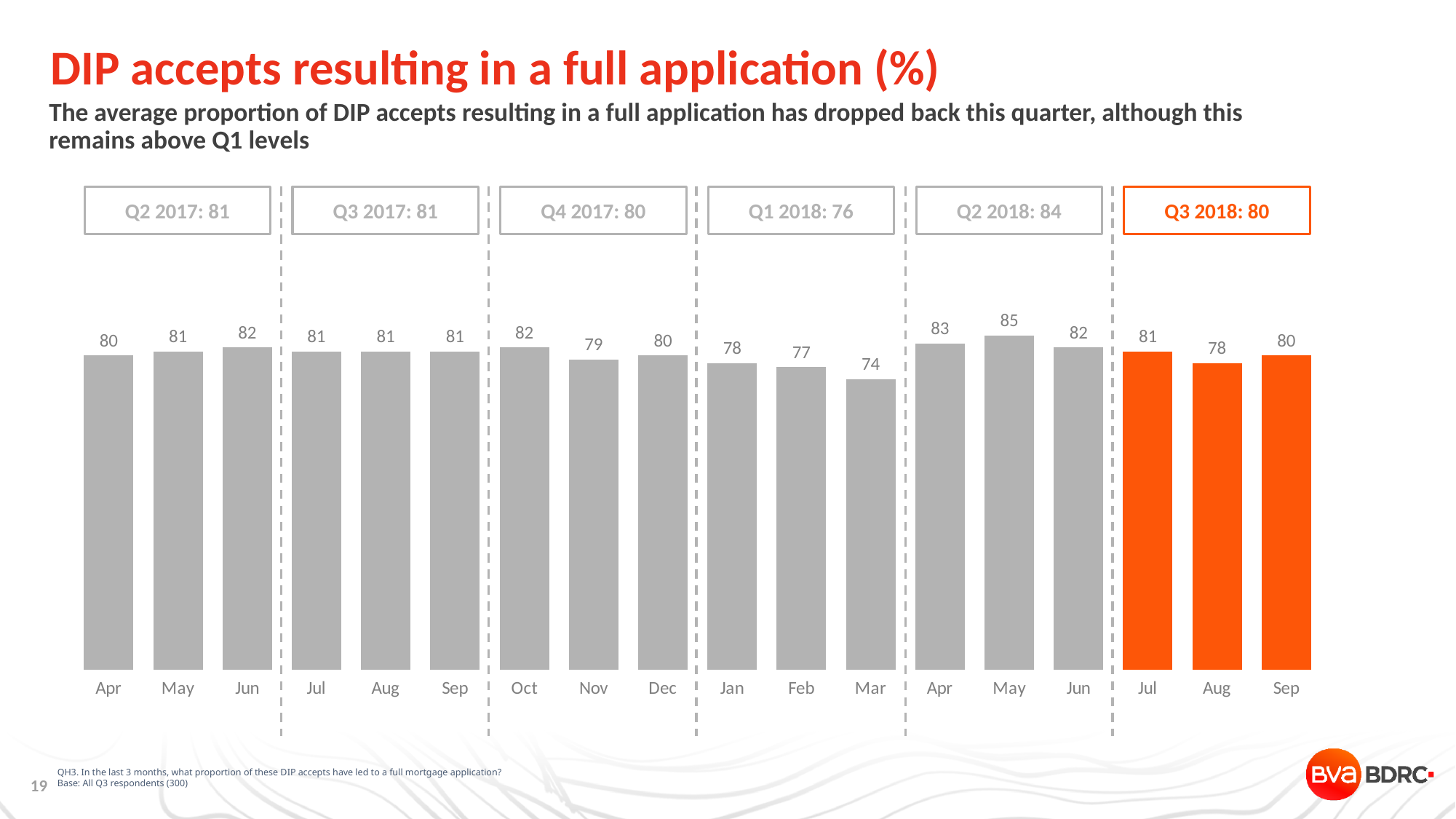
Do the values rise or fall across the three months of Q1 2018 (Jan to Mar)? Fall What is the value for Nov (Q4 2017)? 79 Which month has the highest value on the chart? May (Q2 2018) What is the value for May in Q2 2018? 85 What is the difference between the value for May 2018 and the value for Mar 2018? 11 What kind of chart is shown on the slide? Bar chart What is the value for Sep in Q3 2018? 80 How many monthly bars are plotted on the chart? 18 What quarterly average is shown in the box for Q2 2018? 84 What is the value for Mar (Q1 2018)? 74 Which month has the lowest value on the chart? Mar (Q1 2018) Which is larger, the value for Oct 2017 or the value for Nov 2017? Oct 2017